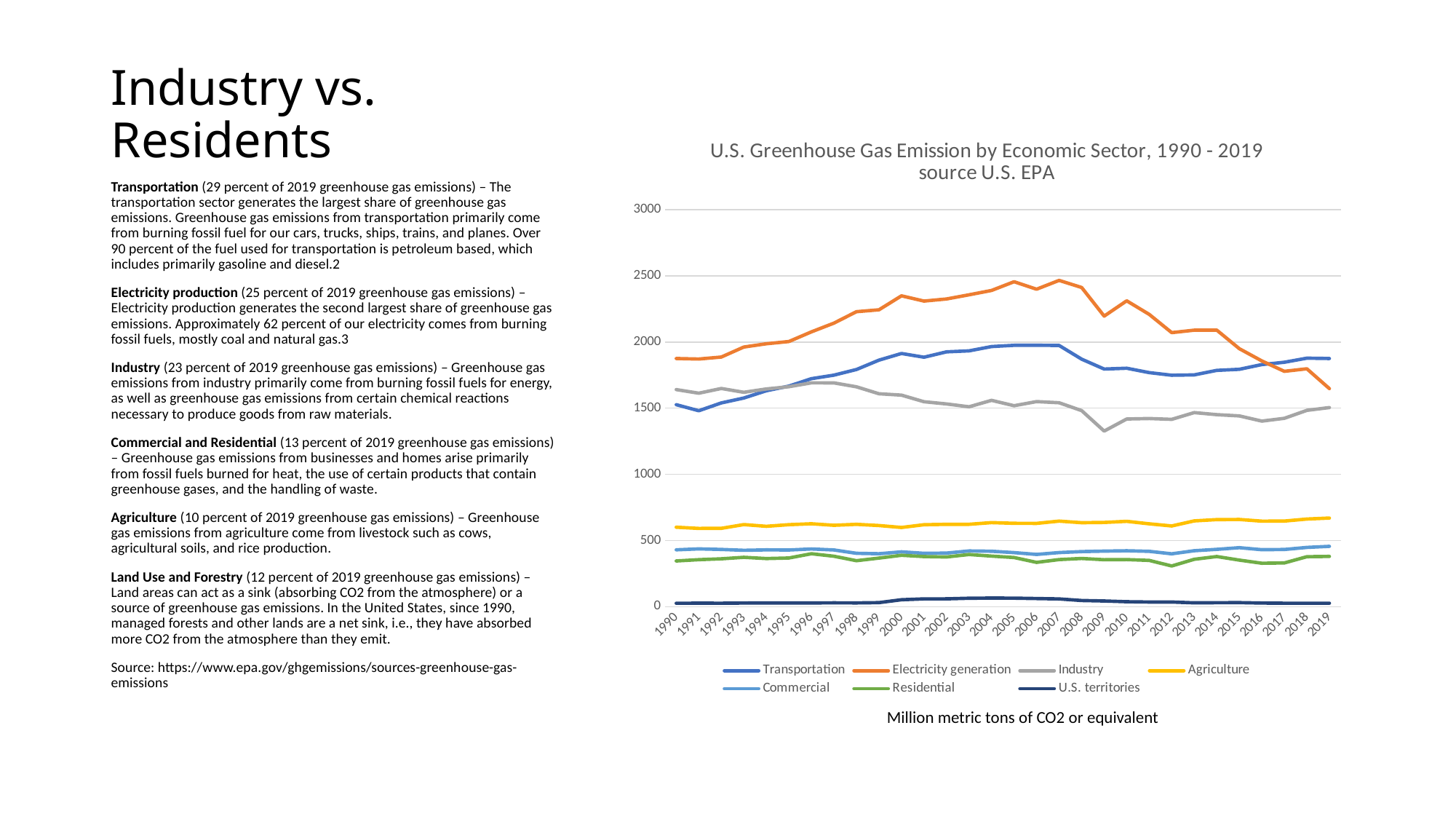
How many years are plotted along the x axis of the chart? 30 Which series has the lowest values across the whole chart? U.S. territories Does the Electricity generation series rise or fall from 2007 to 2019? Fall Is the value for Agriculture in 2019 greater or less than 500? greater What is the title of the chart? U.S. Greenhouse Gas Emission by Economic Sector, 1990 - 2019 source U.S. EPA Is the value for Electricity generation in 2007 greater or less than 2000? greater Is the value for Industry in 2009 greater or less than 1500? less How many series does the chart's legend list? 7 Which series has the highest value in 2007? Electricity generation What kind of chart is shown on the slide? Line chart In 1990, which is larger: Industry or Transportation? Industry Which series has the highest value in 2019? Transportation